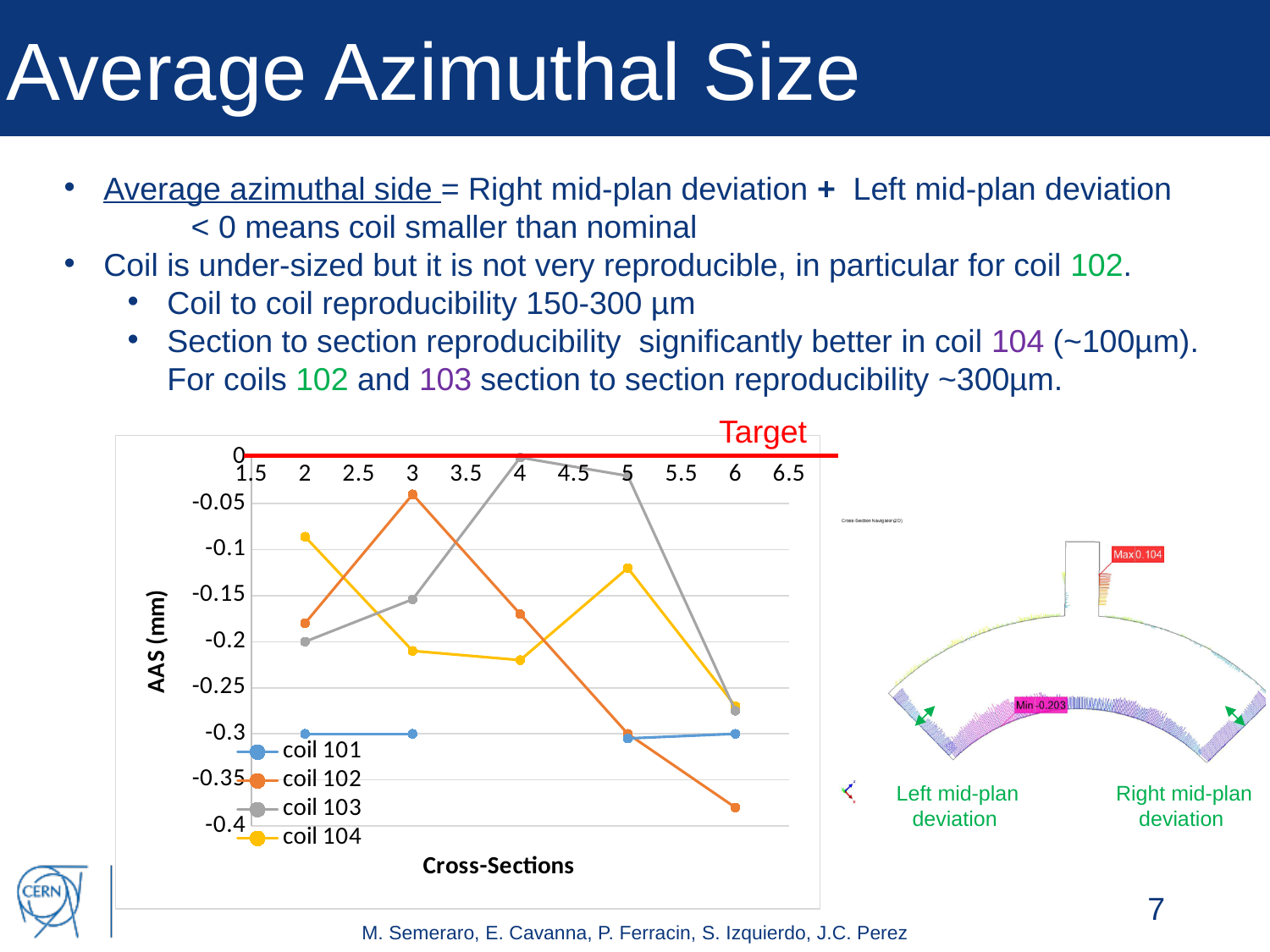
At cross-section 3, which has the larger value, coil 102 or coil 104? coil 102 Is the value for coil 102 at cross-section 6 greater or less than -0.35? less Which coil has the highest value at cross-section 4? coil 103 Is the value for coil 101 at cross-section 2 greater or less than -0.25? less At cross-section 6, which has the larger value, coil 101 or coil 102? coil 101 Which coil has the lowest value at cross-section 6? coil 102 What is the title of the horizontal axis of the chart? Cross-Sections What kind of chart is shown on the slide? line chart Is the value for coil 102 at cross-section 3 greater or less than -0.1? greater How many series does the chart legend list? 4 What is the title of the vertical axis of the chart? AAS (mm)